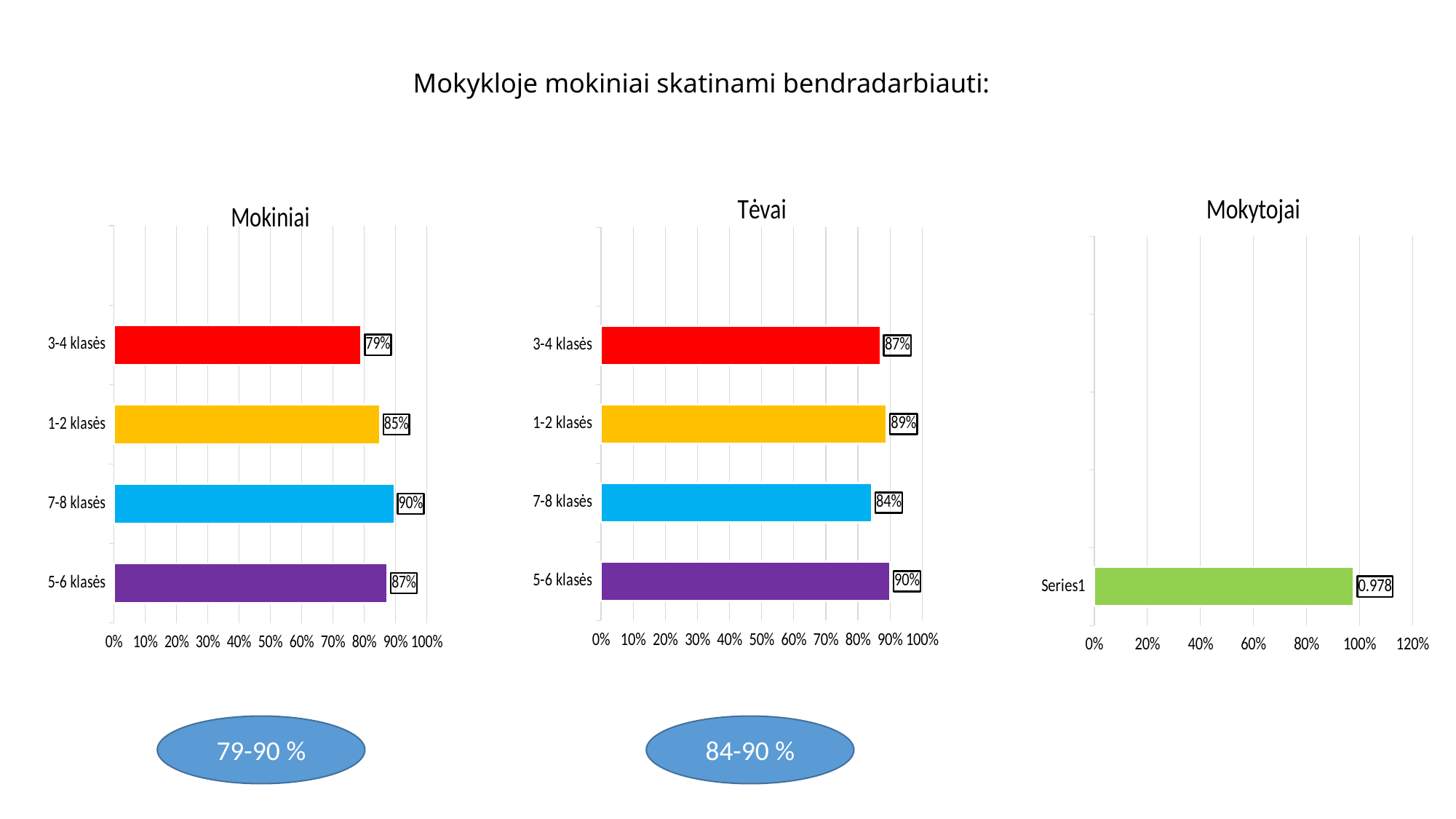
In the Tėvai chart, what is the value for 1-2 klasės? 89% What kind of chart is the Tėvai chart? bar chart In the Tėvai chart, which is larger, the value for 3-4 klasės or the value for 7-8 klasės? 3-4 klasės In the Mokiniai chart, which category has the highest value? 7-8 klasės How many categories does the Mokiniai chart show? 4 In the Mokiniai chart, what is the difference between the values for 7-8 klasės and 1-2 klasės? 5% In the Mokytojai chart, what is the value for Series1? 0.978 In the Mokiniai chart, what colour is the bar for 5-6 klasės? purple In the Mokiniai chart, what is the value for 3-4 klasės? 79% In the Mokiniai chart, which category has the lowest value? 3-4 klasės In the Tėvai chart, which category has the lowest value? 7-8 klasės In the Tėvai chart, which category has the highest value? 5-6 klasės